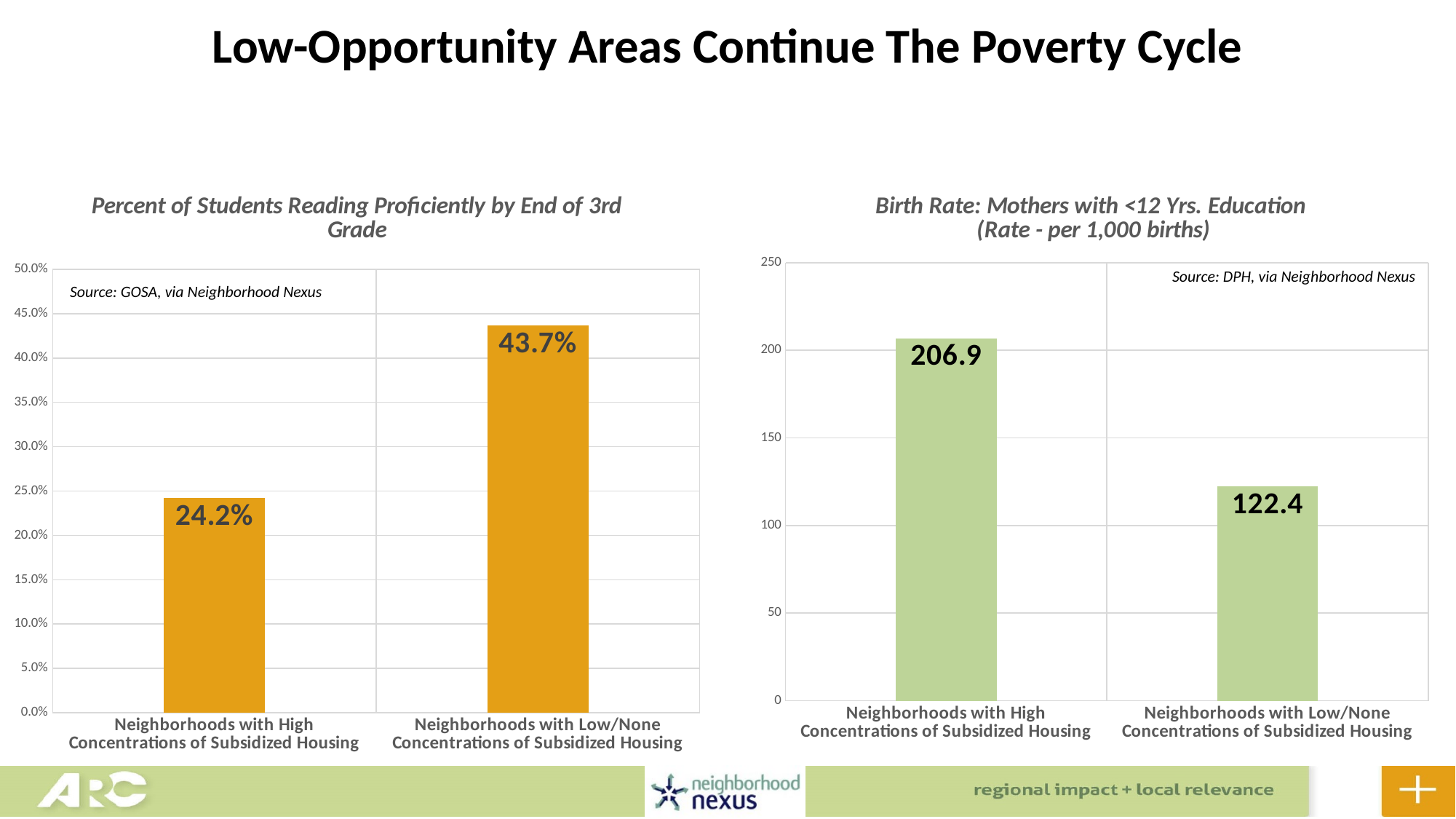
In the 'Percent of Students Reading Proficiently by End of 3rd Grade' chart, what is the value for Neighborhoods with High Concentrations of Subsidized Housing? 24.2% In the 'Percent of Students Reading Proficiently by End of 3rd Grade' chart, what is the difference between the two bars? 19.5% In the 'Birth Rate: Mothers with <12 Yrs. Education' chart, what is the value for Neighborhoods with High Concentrations of Subsidized Housing? 206.9 How many categories are shown in the 'Percent of Students Reading Proficiently by End of 3rd Grade' chart? 2 In the 'Percent of Students Reading Proficiently by End of 3rd Grade' chart, which category has the higher value? Neighborhoods with Low/None Concentrations of Subsidized Housing In the 'Birth Rate: Mothers with <12 Yrs. Education' chart, is the value for Neighborhoods with High Concentrations of Subsidized Housing greater or less than 200? greater What type of chart is the 'Birth Rate: Mothers with <12 Yrs. Education' chart? Bar chart What is the data source cited in the 'Birth Rate: Mothers with <12 Yrs. Education' chart? DPH, via Neighborhood Nexus In the 'Birth Rate: Mothers with <12 Yrs. Education' chart, what is the value for Neighborhoods with Low/None Concentrations of Subsidized Housing? 122.4 In the 'Birth Rate: Mothers with <12 Yrs. Education' chart, what is the difference between the two bars? 84.5 In the 'Percent of Students Reading Proficiently by End of 3rd Grade' chart, what is the value for Neighborhoods with Low/None Concentrations of Subsidized Housing? 43.7% In the 'Birth Rate: Mothers with <12 Yrs. Education' chart, which category has the lower value? Neighborhoods with Low/None Concentrations of Subsidized Housing